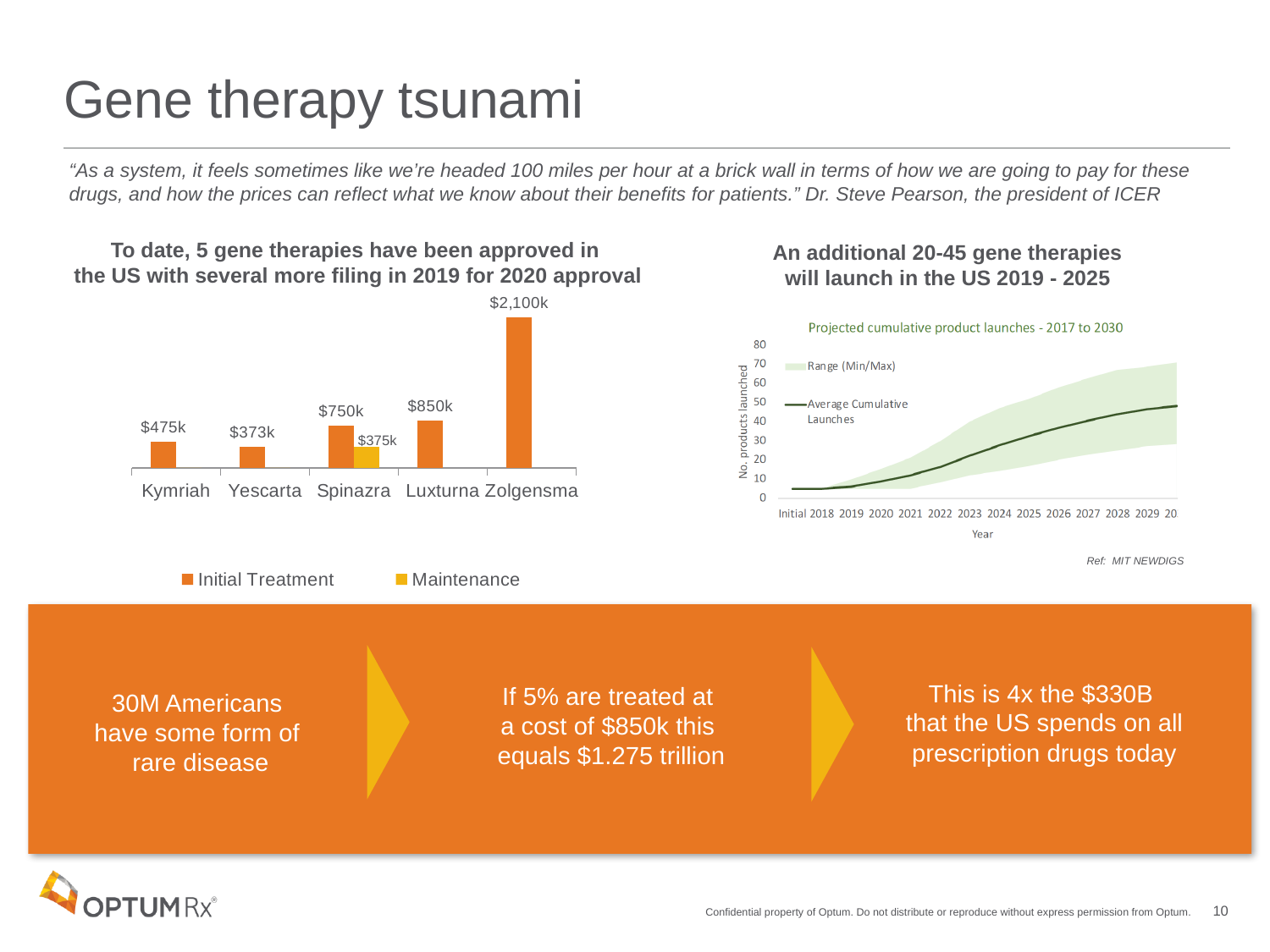
How many gene therapies are shown on the x axis of the left bar chart? 5 In the left bar chart, what is the Initial Treatment cost shown for Zolgensma? $2,100k In the left bar chart, what is the Initial Treatment cost shown for Luxturna? $850k How many series does the legend of the left bar chart list? 2 What kind of chart is the left chart showing gene therapy costs? Bar chart In the left bar chart, what is the Maintenance cost shown for Spinazra? $375k In the left bar chart, which gene therapy has the highest Initial Treatment cost? Zolgensma In the left bar chart, what is the combined Initial Treatment and Maintenance cost for Spinazra? $1,125k In the right chart titled 'Projected cumulative product launches - 2017 to 2030', is the Average Cumulative Launches value at the end of the period greater or less than 40? greater In the right chart titled 'Projected cumulative product launches - 2017 to 2030', does the Average Cumulative Launches line rise or fall over the years? Rise In the left bar chart, which gene therapy has the lowest Initial Treatment cost? Yescarta In the left bar chart, what is the difference between the Initial Treatment costs of Zolgensma and Luxturna? $1,250k